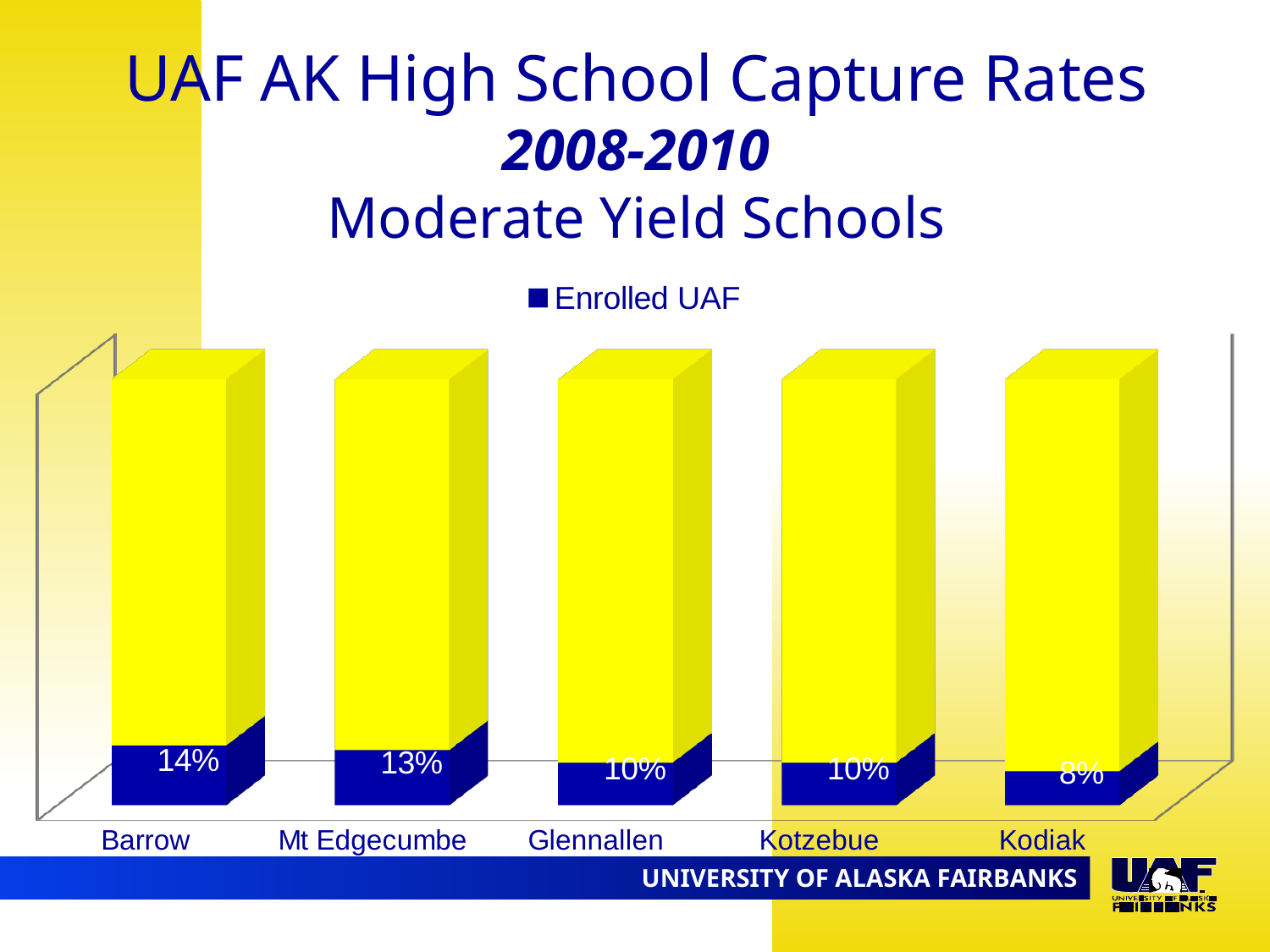
What is the Enrolled UAF value for Kotzebue? 10% What kind of chart is shown on the slide? Bar chart Which has a higher Enrolled UAF rate, Mt Edgecumbe or Glennallen? Mt Edgecumbe What is the Enrolled UAF value for Kodiak? 8% What is the Enrolled UAF value for Mt Edgecumbe? 13% What is the difference between the Enrolled UAF rates for Barrow and Kodiak? 6 percentage points What is the Enrolled UAF value for Barrow? 14% How many schools are shown on the x axis of the chart? 5 How many series does the chart legend list? 1 Which school has the highest Enrolled UAF capture rate? Barrow Do the Enrolled UAF values rise or fall from Barrow to Kodiak along the x axis? Fall Which school has the lowest Enrolled UAF capture rate? Kodiak